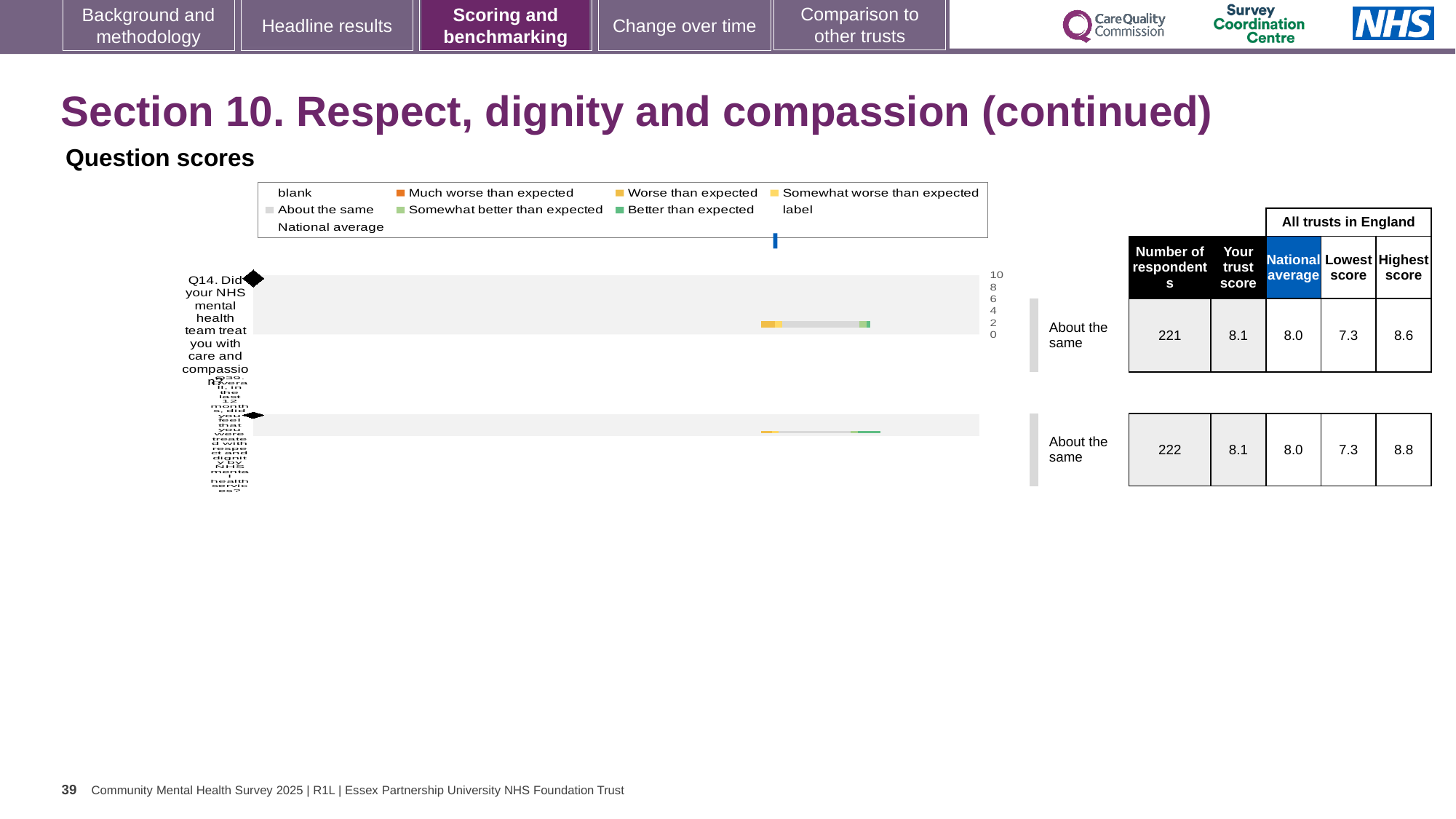
How many questions are plotted in the question scores chart? 2 What is the difference between the highest score and the lowest score for Q14 in the table? 1.3 For Q14, is the trust score higher or lower than the national average in the table? higher What is the national average for Q14 in the table? 8.0 What is the highest value shown on the score axis of the question scores chart? 10 Which question has the higher 'Highest score' in the table, Q14 or Q39? Q39 Which benchmark category is shown next to the bar for Q14? About the same What is the trust score for Q14 in the table? 8.1 What is the highest score across all trusts in England for Q39 in the table? 8.8 How many respondents are listed for Q14 in the table? 221 What kind of chart is used to show the question scores on this slide? bar chart How many entries does the legend of the question scores chart list? 9